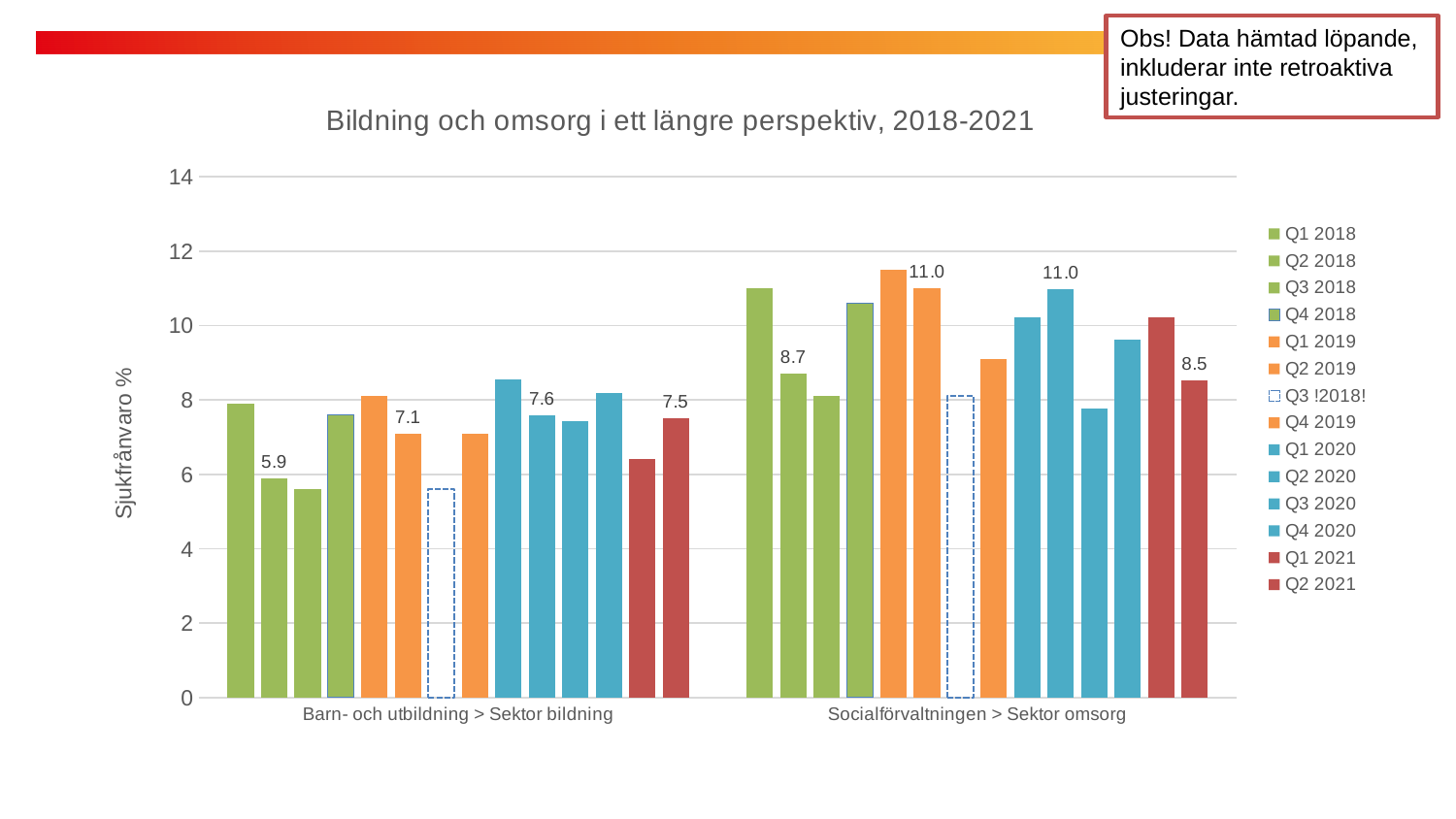
What is the difference between the Q2 2019 and Q2 2018 values for Socialförvaltningen > Sektor omsorg? 2.3 What is the Q2 2019 value for Socialförvaltningen > Sektor omsorg? 11.0 Is the Q3 2018 value for Barn- och utbildning > Sektor bildning greater or less than 6? less Is the Q1 2019 value for Socialförvaltningen > Sektor omsorg greater or less than 10? greater What is the Q2 2018 value for Barn- och utbildning > Sektor bildning? 5.9 What is the Q2 2020 value for Barn- och utbildning > Sektor bildning? 7.6 What is the difference between the Q2 2020 and Q2 2019 values for Barn- och utbildning > Sektor bildning? 0.5 What kind of chart is shown on the slide? Bar chart How many categories are shown on the x axis? 2 How many series does the legend list? 14 What is the Q2 2021 value for Socialförvaltningen > Sektor omsorg? 8.5 Which is larger for Q2 2021: Barn- och utbildning > Sektor bildning or Socialförvaltningen > Sektor omsorg? Socialförvaltningen > Sektor omsorg